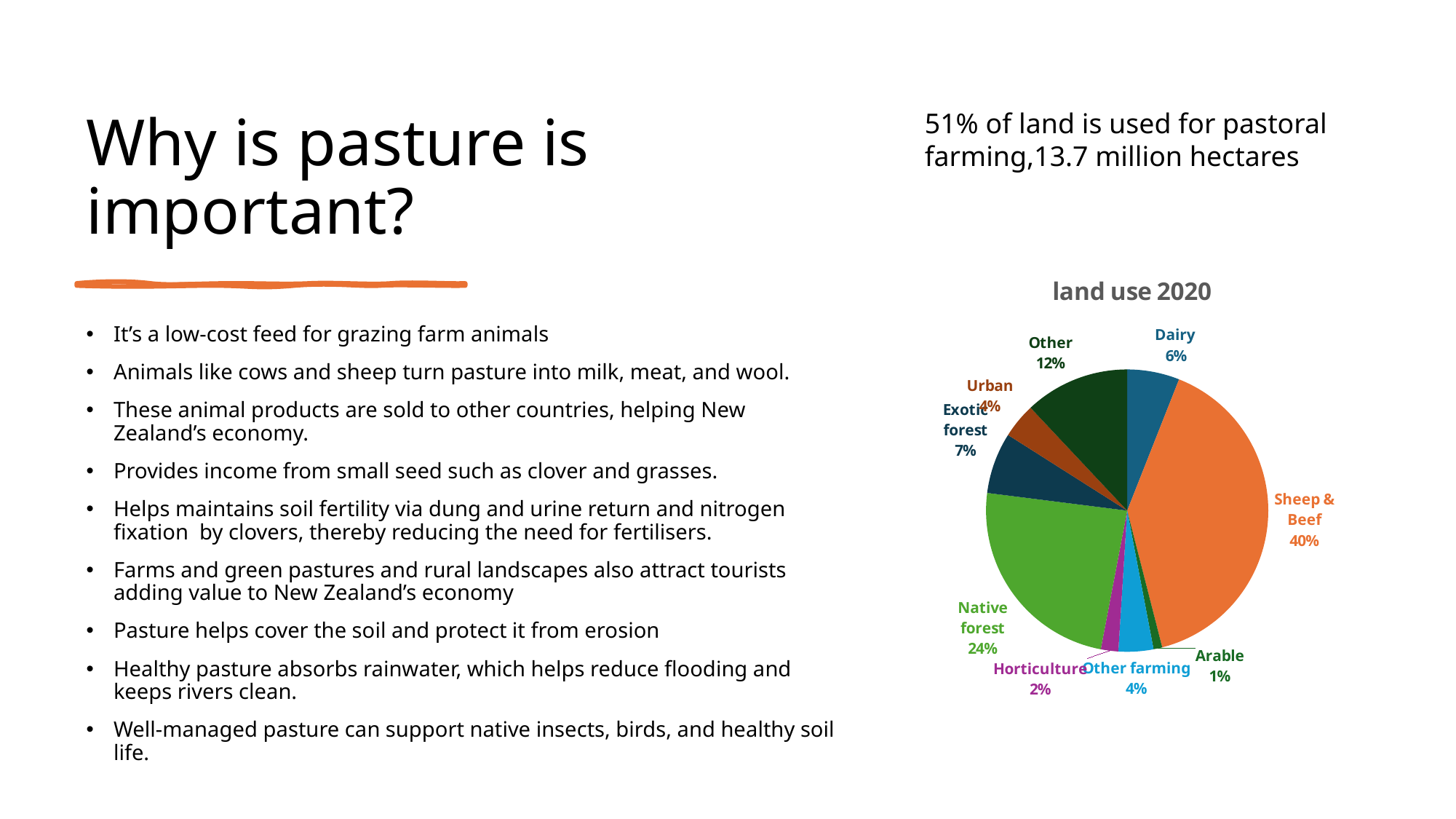
What kind of chart is shown on the slide? pie chart What share of land use is Dairy? 6% What share of land use is Sheep & Beef? 40% Which category has the largest slice of the pie? Sheep & Beef What share of land use is Native forest? 24% What share of land use is Exotic forest? 7% What is the title of the chart? land use 2020 Which category has the smallest slice of the pie? Arable What is the difference between the Sheep & Beef share and the Native forest share? 16% Which is larger, the Other slice or the Exotic forest slice? Other How many slices does the pie chart have? 9 What share of land use is Other farming? 4%